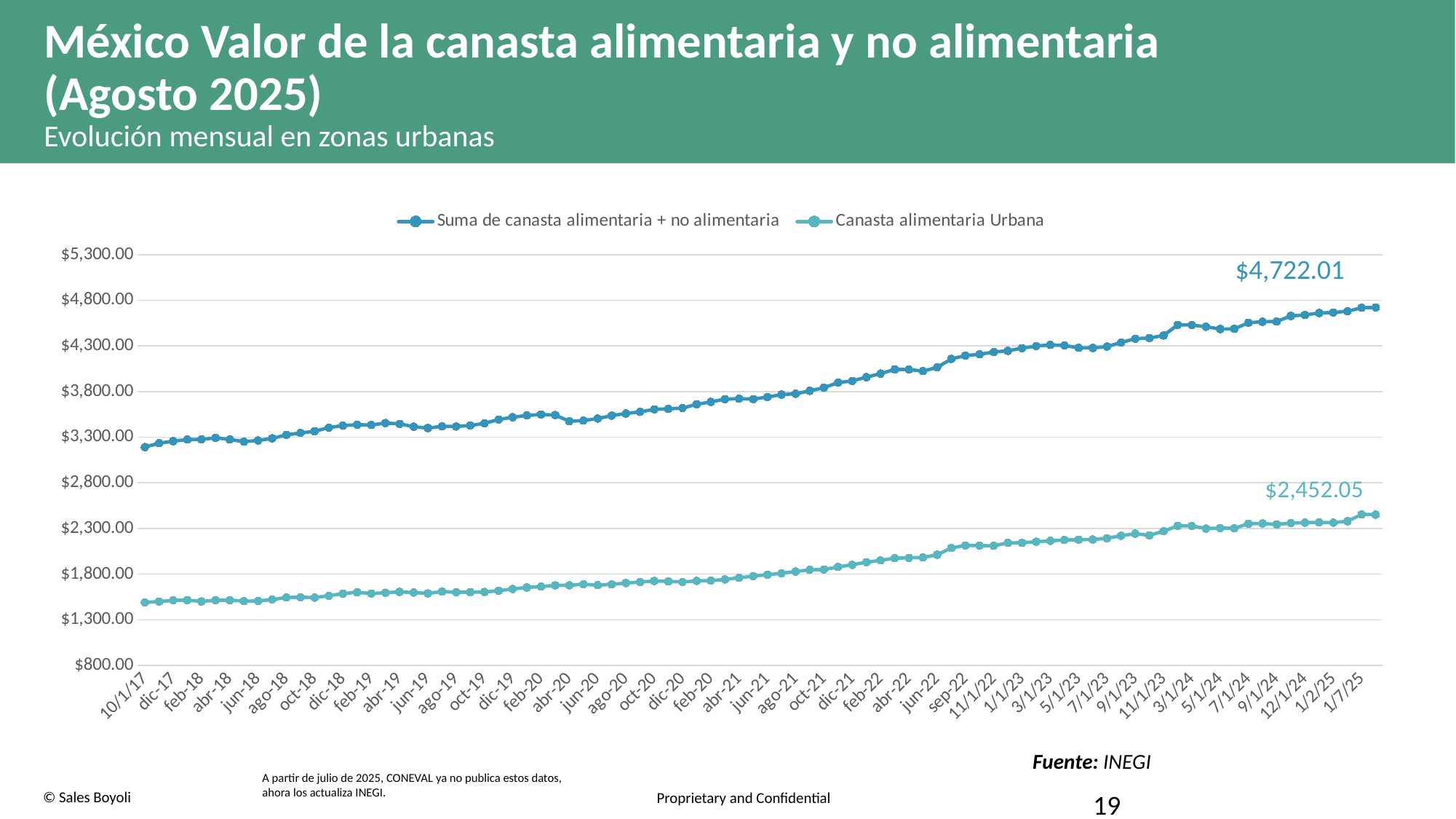
How many series does the legend list? 2 What is the labelled value of the 'Suma de canasta alimentaria + no alimentaria' series at the end of the chart? $4,722.01 Is the value of 'Suma de canasta alimentaria + no alimentaria' at 10/1/17 greater or less than $3,300.00? less What kind of chart is shown on the slide? line chart Which series has the higher values throughout the chart? Suma de canasta alimentaria + no alimentaria What is the labelled value of the 'Canasta alimentaria Urbana' series at the end of the chart? $2,452.05 What is the difference between the two labelled values, $4,722.01 and $2,452.05? $2,269.96 What is the subtitle shown below the main title of the slide? Evolución mensual en zonas urbanas Do the values of both series generally rise or fall from left to right along the x axis? rise What is the first date label shown on the x axis? 10/1/17 Is the value of 'Suma de canasta alimentaria + no alimentaria' at 1/7/25 greater or less than $4,300.00? greater Is the value of 'Canasta alimentaria Urbana' at 10/1/17 greater or less than $1,800.00? less